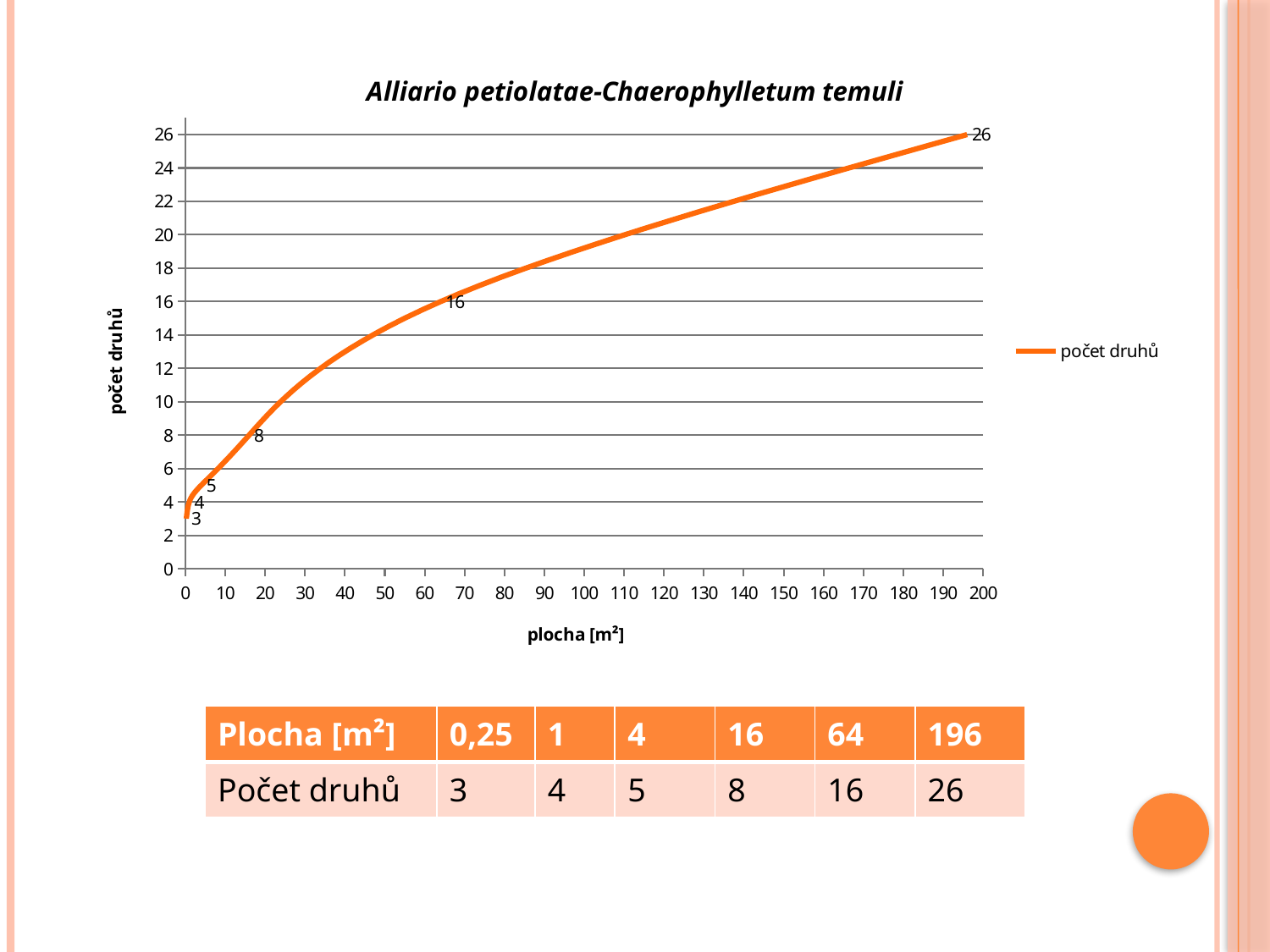
How many data points are plotted on the line? 6 What is the number of species (počet druhů) at an area of 196 m²? 26 What is the label of the x axis? plocha [m²] What kind of chart is shown on the slide? line chart What is the lowest value of počet druhů plotted on the chart? 3 What is the number of species (počet druhů) at an area of 64 m²? 16 How many series does the legend list? 1 What is the title of the chart? Alliario petiolatae-Chaerophylletum temuli What is the highest value of počet druhů plotted on the chart? 26 What is the number of species (počet druhů) at an area of 16 m²? 8 What is the difference between the number of species at 196 m² and at 64 m²? 10 Does the number of species rise or fall as the area (plocha) increases? rise